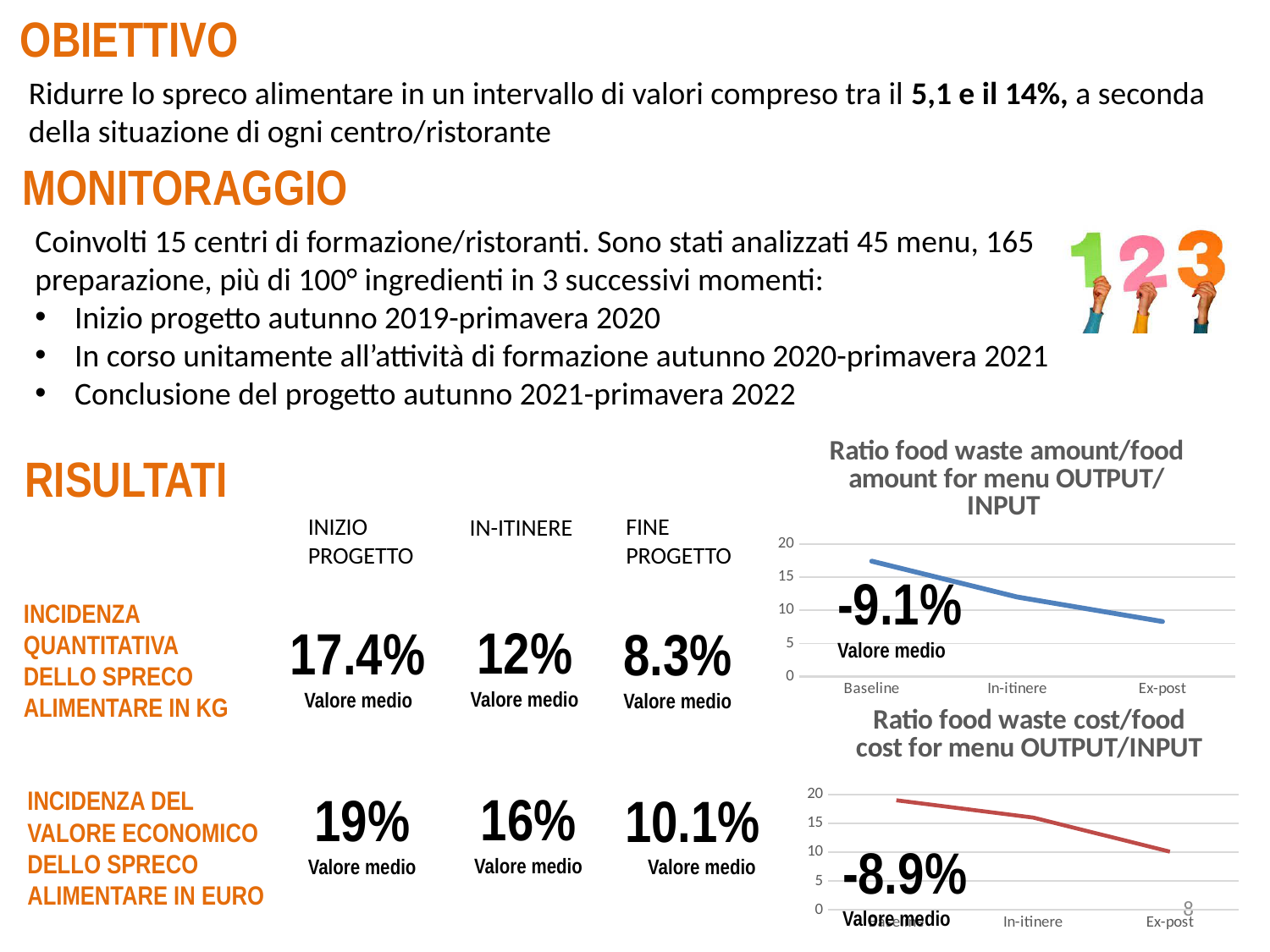
In the top chart (Ratio food waste amount/food amount), which category has the highest value? Baseline In the bottom chart (Ratio food waste cost/food cost), what are the three x-axis categories? Baseline, In-itinere, Ex-post What type of chart is the bottom chart titled "Ratio food waste cost/food cost for menu OUTPUT/INPUT"? Line chart In the top chart (Ratio food waste amount/food amount), which category has the lowest value? Ex-post In the bottom chart (Ratio food waste cost/food cost), do the values rise or fall from Baseline to Ex-post? Fall In the top chart (Ratio food waste amount/food amount), do the values rise or fall from Baseline to Ex-post? Fall In the top chart (Ratio food waste amount/food amount), how many points are plotted along the x axis? 3 In the top chart (Ratio food waste amount/food amount), is the value for Baseline greater or less than 15? greater In the bottom chart (Ratio food waste cost/food cost), is the value for Ex-post greater or less than 15? less In the bottom chart (Ratio food waste cost/food cost), which is larger, the value for Baseline or the value for In-itinere? Baseline What type of chart is the top chart titled "Ratio food waste amount/food amount for menu OUTPUT/INPUT"? Line chart In the bottom chart (Ratio food waste cost/food cost), which category has the lowest value? Ex-post